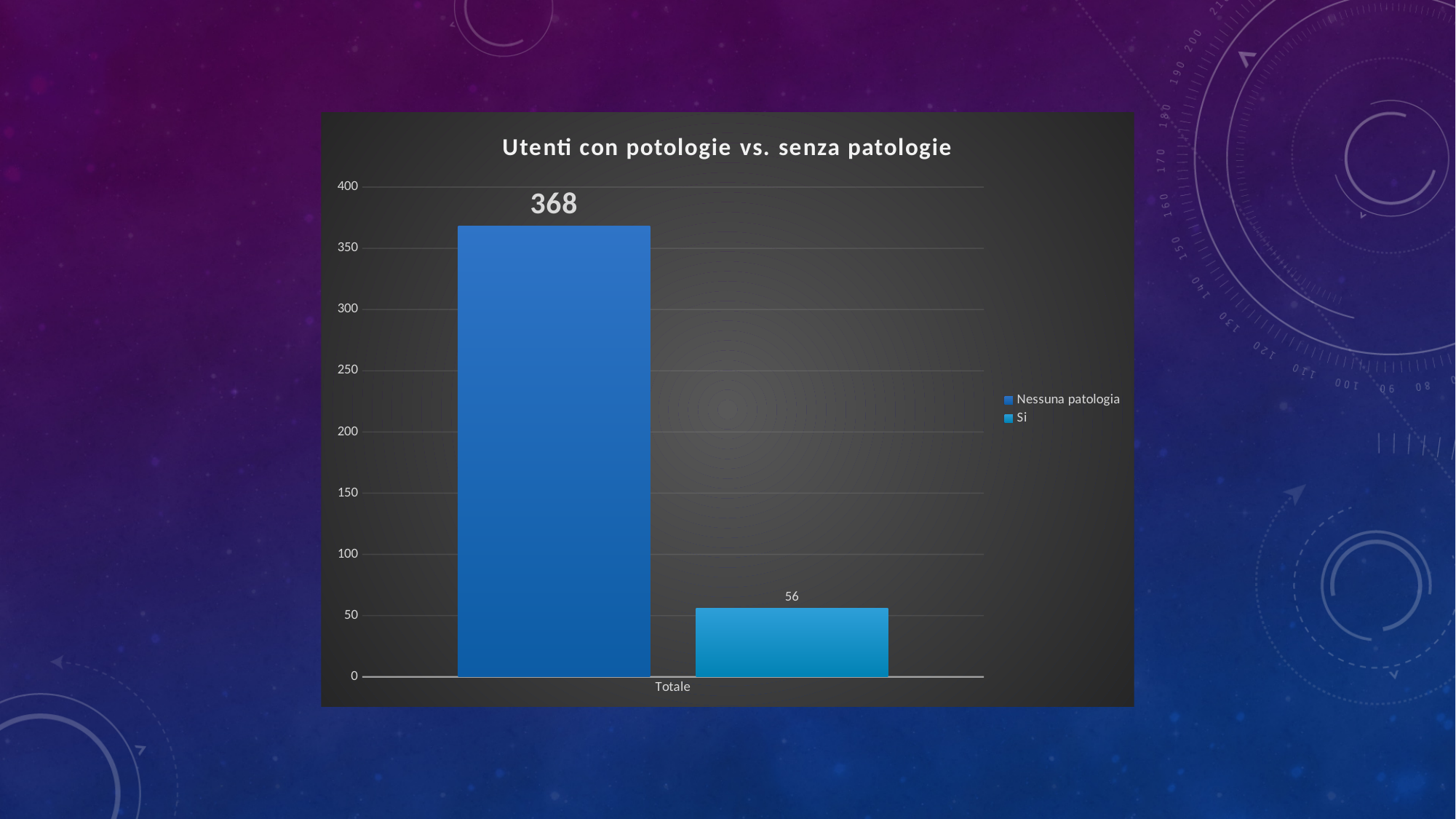
Which is larger, the value for Nessuna patologia or the value for Si? Nessuna patologia What is the value for Si? 56 Which series has the highest value? Nessuna patologia Which series has the lowest value? Si What is the difference between the values for Nessuna patologia and Si? 312 Is the value for Nessuna patologia greater or less than 350? greater What is the title of the chart? Utenti con potologie vs. senza patologie What is the category label on the x axis? Totale How many series does the legend list? 2 What is the value for Nessuna patologia? 368 What kind of chart is shown on the slide? bar chart Is the value for Si greater or less than 100? less